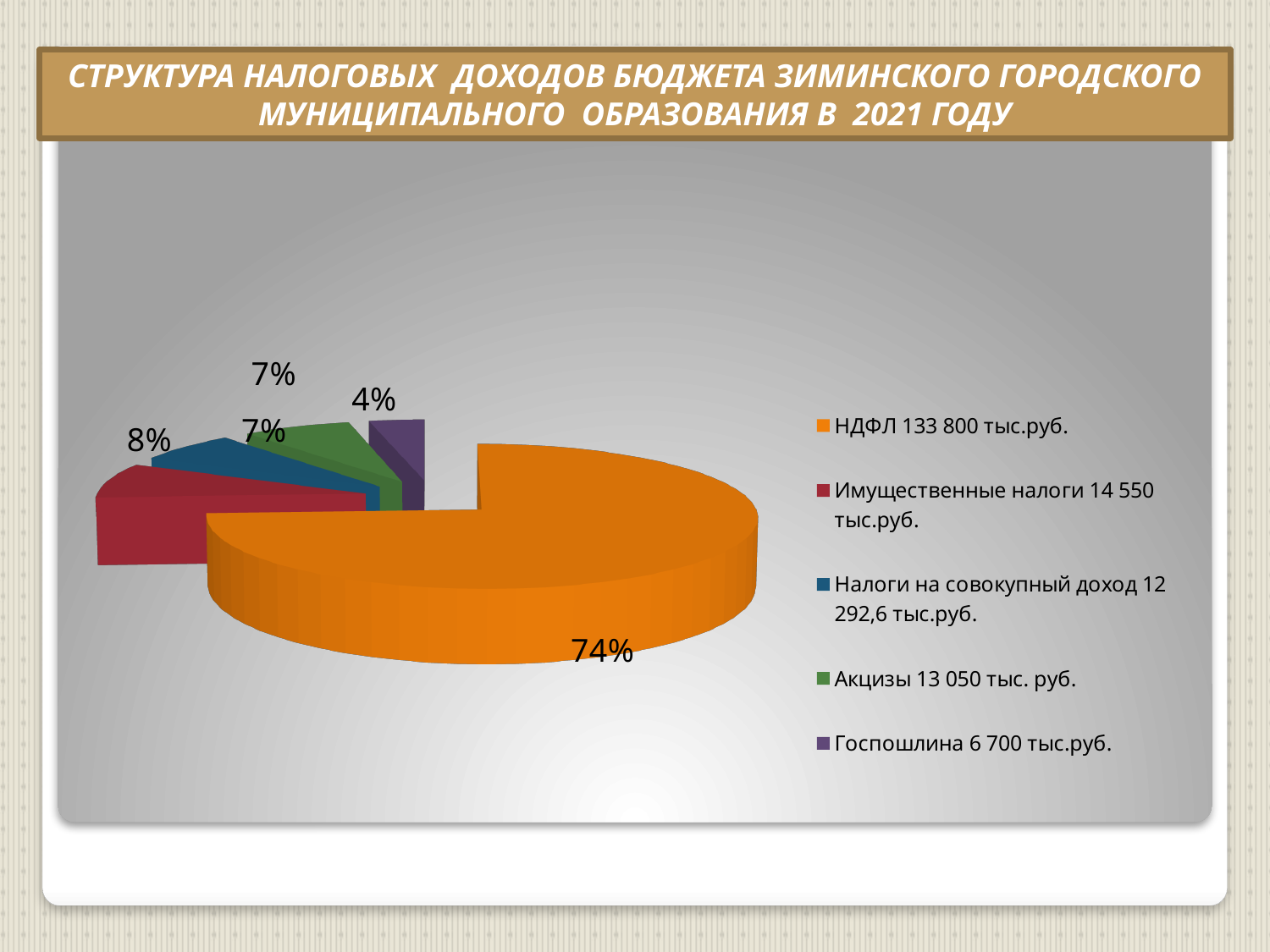
What share of the pie does Акцизы account for? 7% How many slices does the pie chart have? 5 What share of the pie does Имущественные налоги account for? 8% What share of the pie does Госпошлина account for? 4% Which category has the smallest slice of the pie? Госпошлина According to the legend, what amount in тыс.руб. is given for Акцизы? 13 050 тыс. руб. Which slice is larger, Имущественные налоги or Госпошлина? Имущественные налоги What colour is the НДФЛ slice in the pie chart? orange What kind of chart is shown on the slide? pie chart What is the difference in percentage points between the НДФЛ slice and the Имущественные налоги slice? 66 Which category has the largest slice of the pie? НДФЛ